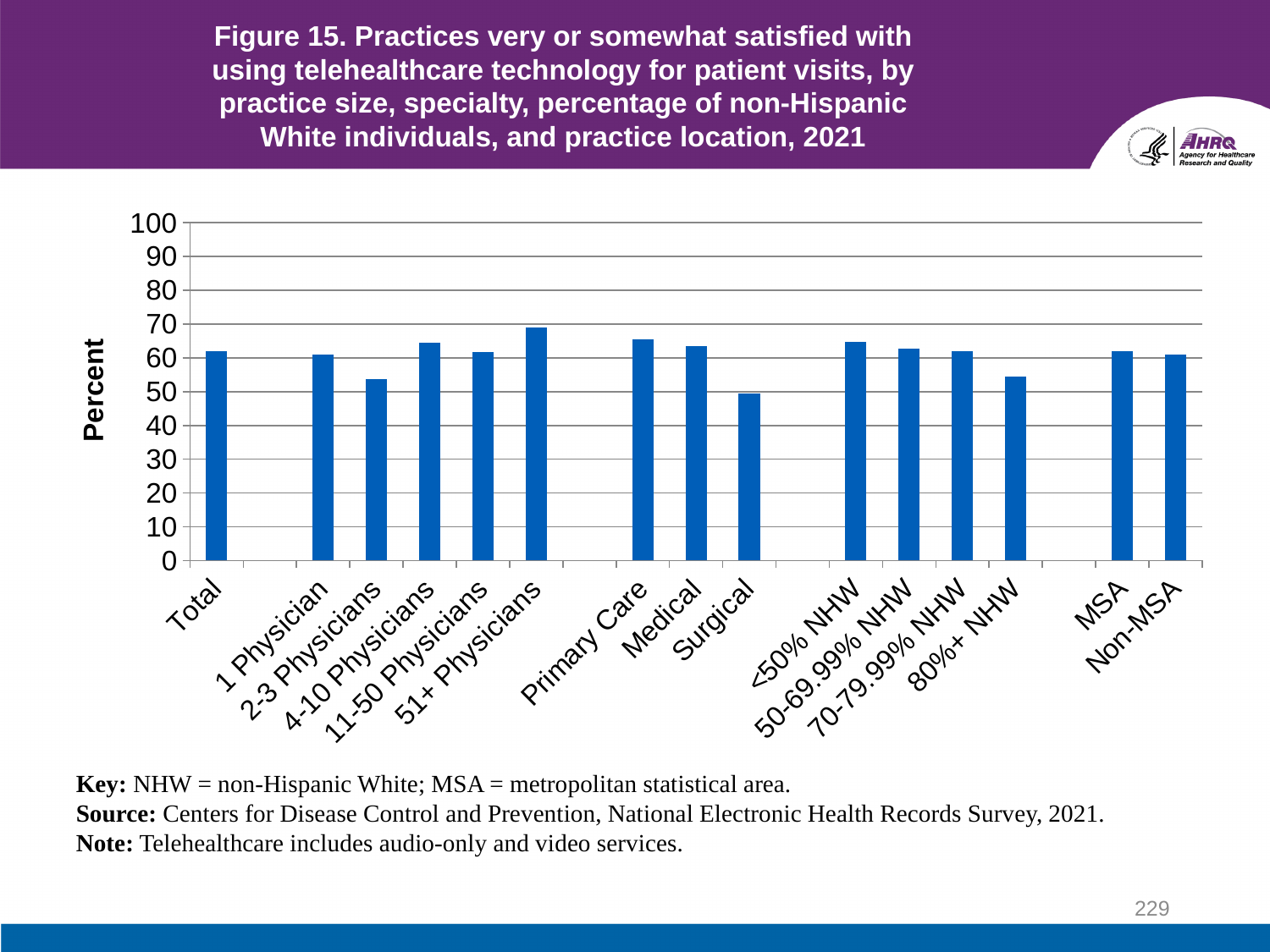
What kind of chart is shown on the slide? bar chart Is the value for 51+ Physicians greater or less than 60? greater How many bars (categories) are plotted in the chart? 15 What is the label on the vertical axis of the chart? Percent Which category has the lowest percentage of practices satisfied with telehealthcare technology? Surgical Which is larger, the value for Primary Care or the value for Surgical? Primary Care Is the value for 2-3 Physicians greater or less than 60? less Is the value for Total greater or less than 50? greater Which category has the highest percentage of practices satisfied with telehealthcare technology? 51+ Physicians Which is larger, the value for 51+ Physicians or the value for 2-3 Physicians? 51+ Physicians Which is larger, the value for <50% NHW or the value for 80%+ NHW? <50% NHW